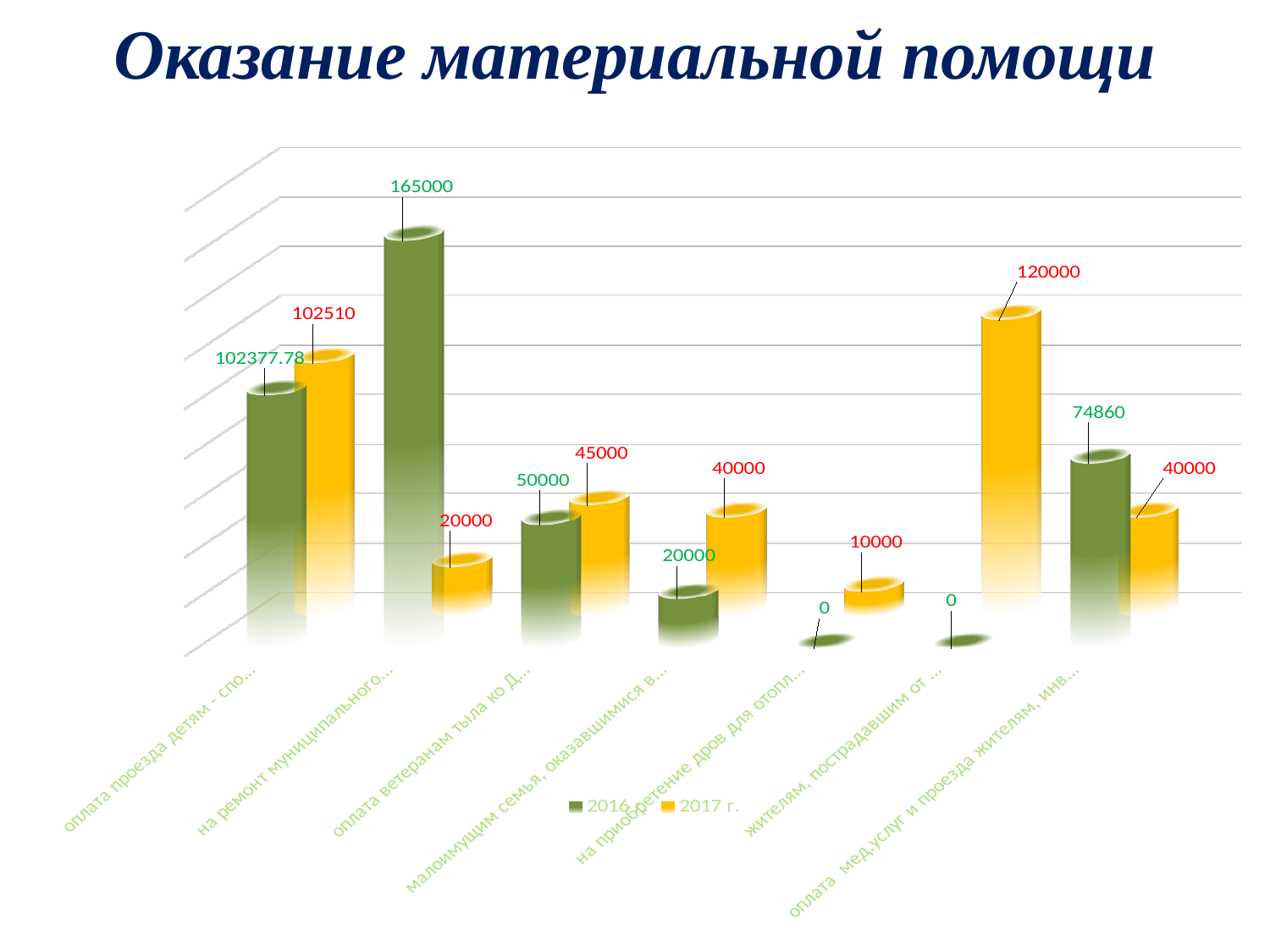
For the category beginning "малоимущим семья", which series has the larger value, 2016 г. or 2017 г.? 2017 г. What type of chart is shown on the slide? bar chart What is the 2017 г. value for the category beginning "оплата мед.услуг и проезда жителям"? 40000 Which category has the highest 2016 г. value? на ремонт муниципального... How many categories are shown on the x axis? 7 What is the 2016 г. value for the category beginning "оплата проезда детям"? 102377.78 What is the 2017 г. value for the category beginning "жителям, пострадавшим от"? 120000 What is the title of the slide? Оказание материальной помощи What is the 2016 г. value for the category beginning "на ремонт муниципального"? 165000 What is the difference between the 2016 г. and 2017 г. values for the category beginning "на ремонт муниципального"? 145000 Which category has the lowest 2017 г. value? на приобретение дров для отопл... How many series does the legend list? 2